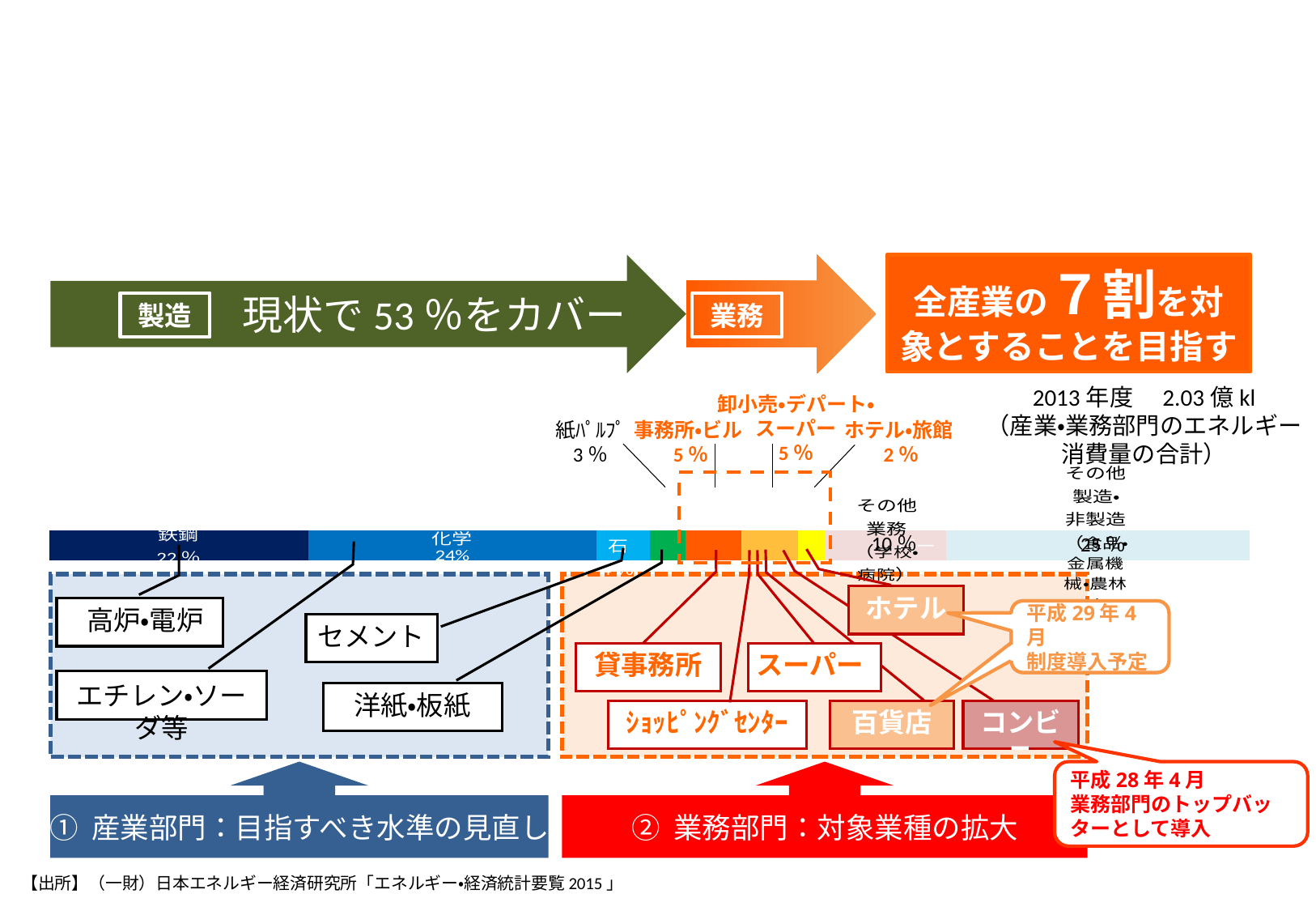
What share does 化学 (chemicals) account for in the stacked bar? 24% What share does 鉄鋼 (steel) account for in the stacked bar? 22 % Which has the larger share, 鉄鋼 or 化学? 化学 What share is shown for 紙パルプ (paper/pulp)? 3 % What kind of chart is used to show the energy consumption breakdown? Stacked bar chart What is the difference in share between 事務所・ビル and ホテル・旅館? 3% What is the difference in share between 化学 and 鉄鋼? 2% What is the combined share of 事務所・ビル, 卸小売・デパート・スーパー and ホテル・旅館 (the three segments in the orange dashed box)? 12% What share is shown for その他業務 (other business, e.g. schools and hospitals)? 10 % What fiscal year and total energy consumption are stated for the bar chart? 2013年度 2.03億kl What share is shown for ホテル・旅館 (hotels/inns)? 2 % What share is shown for 事務所・ビル (offices/buildings)? 5 %